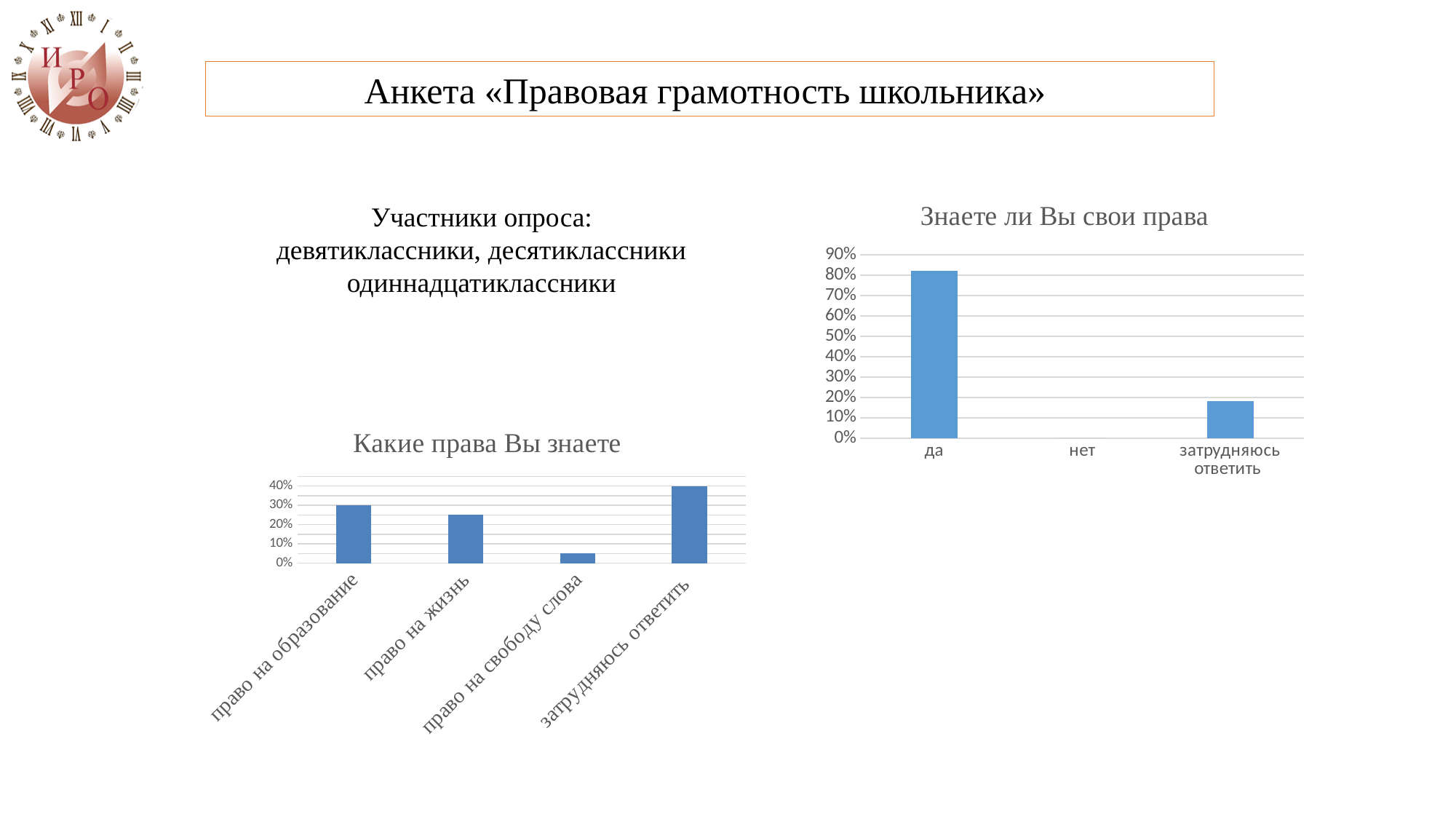
In the chart «Знаете ли Вы свои права», which category has the highest value? да What kind of chart is the chart titled «Знаете ли Вы свои права»? bar chart How many categories are shown on the x axis of the chart «Какие права Вы знаете»? 4 What kind of chart is the chart titled «Какие права Вы знаете»? bar chart In the chart «Какие права Вы знаете», which is larger: the value for «право на образование» or the value for «право на жизнь»? право на образование In the chart «Знаете ли Вы свои права», is the value for «затрудняюсь ответить» greater or less than 30%? less In the chart «Какие права Вы знаете», which category has the lowest value? право на свободу слова How many categories are shown on the x axis of the chart «Знаете ли Вы свои права»? 3 In the chart «Какие права Вы знаете», is the value for «право на свободу слова» greater or less than 10%? less In the chart «Знаете ли Вы свои права», which is larger: the value for «да» or the value for «затрудняюсь ответить»? да In the chart «Знаете ли Вы свои права», is the value for «да» greater or less than 70%? greater In the chart «Какие права Вы знаете», which category has the highest value? затрудняюсь ответить